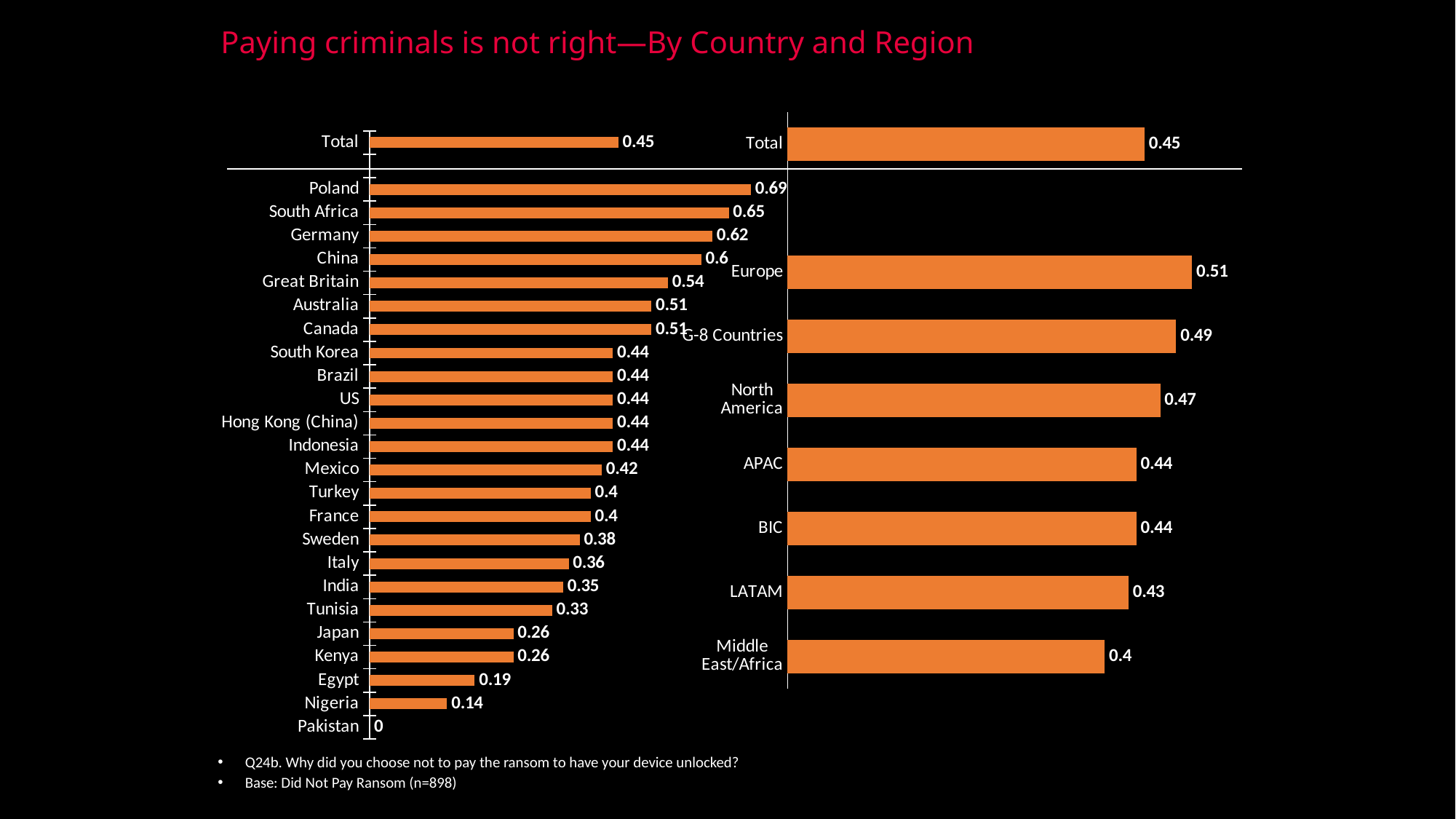
In the left chart (by country), what is the value for Japan? 0.26 In the left chart (by country), what is the value for Poland? 0.69 In the right chart (by region), which region has the lowest value? Middle East/Africa In the right chart (by region), what is the value for North America? 0.47 In the right chart (by region), which region has the highest value? Europe What type of chart is the left chart (by country)? Bar chart What is the title of the slide? Paying criminals is not right—By Country and Region In the left chart (by country), which is larger, the value for South Africa or the value for Great Britain? South Africa In the right chart (by region), how many regions are shown below the Total bar? 7 In the left chart (by country), which country has the lowest value? Pakistan In the left chart (by country), what is the difference between the values for Germany and Italy? 0.26 In the right chart (by region), what is the difference between the values for Europe and LATAM? 0.08